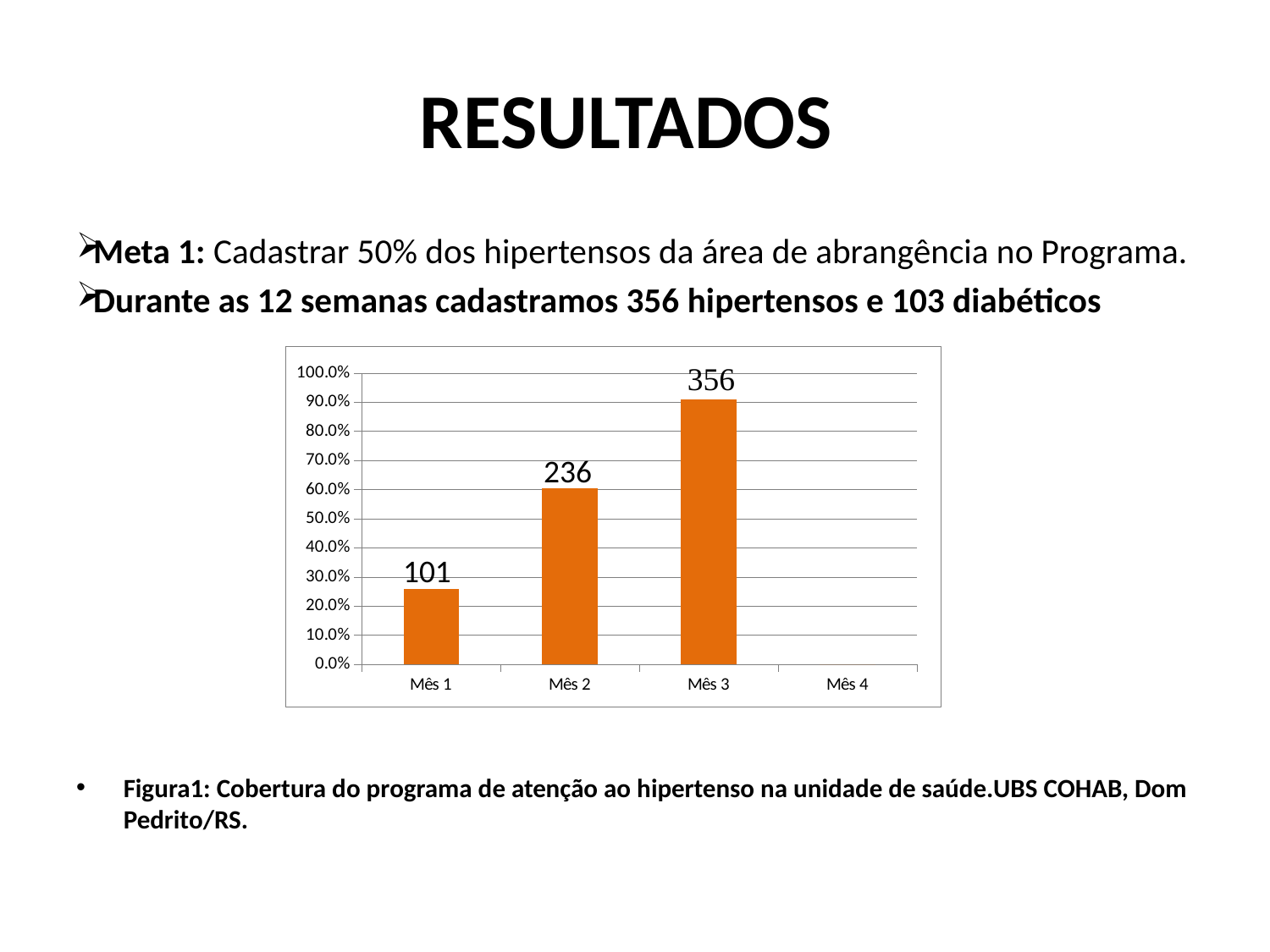
How many categories are shown on the x axis of the chart? 4 What kind of chart is shown on the slide? Bar chart What data label is shown on the bar for Mês 1? 101 What data label is shown on the bar for Mês 2? 236 What is the difference between the data labels for Mês 3 and Mês 1? 255 Which bar is taller, Mês 2 or Mês 3? Mês 3 Is the bar for Mês 1 greater or less than 30.0% on the axis? less Among the months with a plotted bar, which has the shortest bar? Mês 1 Is the bar for Mês 3 greater or less than 80.0% on the axis? greater What data label is shown on the bar for Mês 3? 356 Which month has the tallest bar in the chart? Mês 3 What is the difference between the data labels for Mês 2 and Mês 1? 135